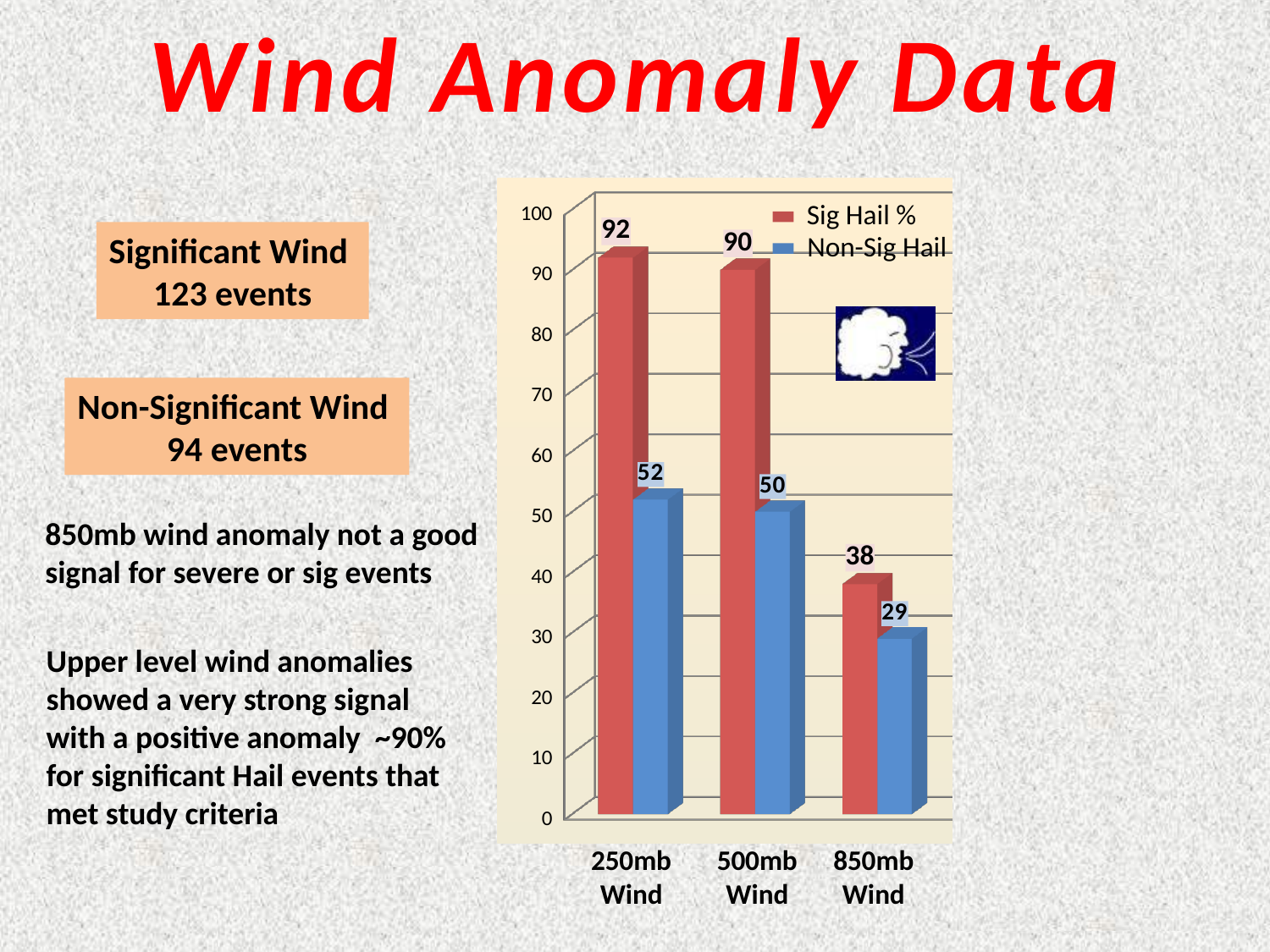
How many series does the chart legend list? 2 What is the Sig Hail % value for 250mb Wind? 92 Which is larger for 850mb Wind: the Sig Hail % value or the Non-Sig Hail value? Sig Hail % Which category has the highest Sig Hail % value? 250mb Wind What is the Non-Sig Hail value for 850mb Wind? 29 Do the Sig Hail % values rise or fall from 250mb Wind to 850mb Wind? Fall What is the difference between the Sig Hail % values for 500mb Wind and 850mb Wind? 52 What is the Non-Sig Hail value for 500mb Wind? 50 Which category has the lowest Non-Sig Hail value? 850mb Wind How many categories are shown on the x axis of the chart? 3 What kind of chart is shown on the slide? Bar chart What is the difference between the Sig Hail % and Non-Sig Hail values for 250mb Wind? 40